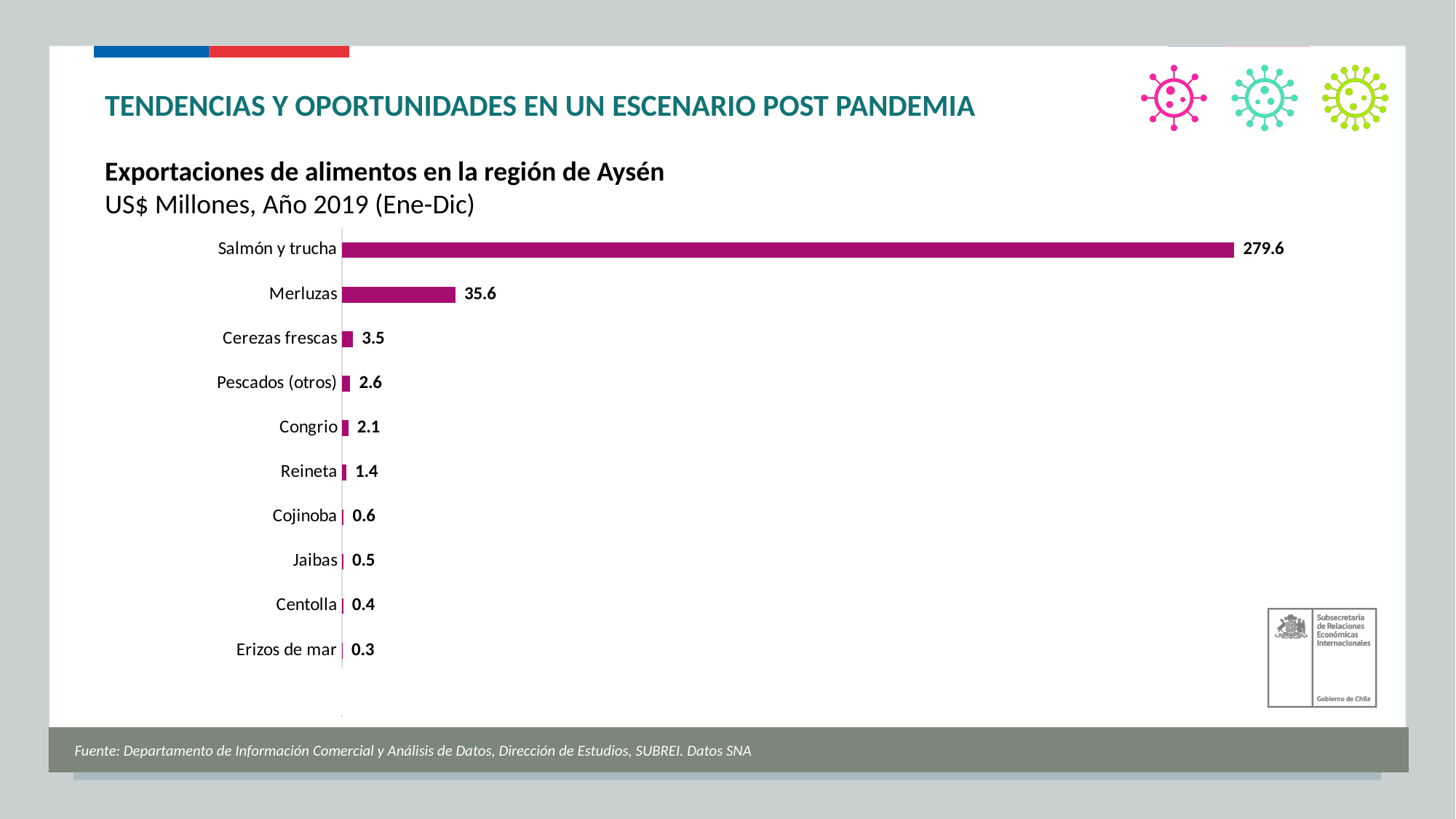
What is the export value for Salmón y trucha? 279.6 What kind of chart is shown on the slide? Bar chart What is the title of the chart? Exportaciones de alimentos en la región de Aysén How many categories are shown in the chart? 10 What is the export value for Merluzas? 35.6 Which category has the lowest export value? Erizos de mar What is the difference between the export values of Salmón y trucha and Merluzas? 244.0 What is the export value for Cerezas frescas? 3.5 Which has a larger export value, Pescados (otros) or Congrio? Pescados (otros) What is the difference between the export values of Cojinoba and Centolla? 0.2 Which category has the highest export value? Salmón y trucha What is the export value for Reineta? 1.4